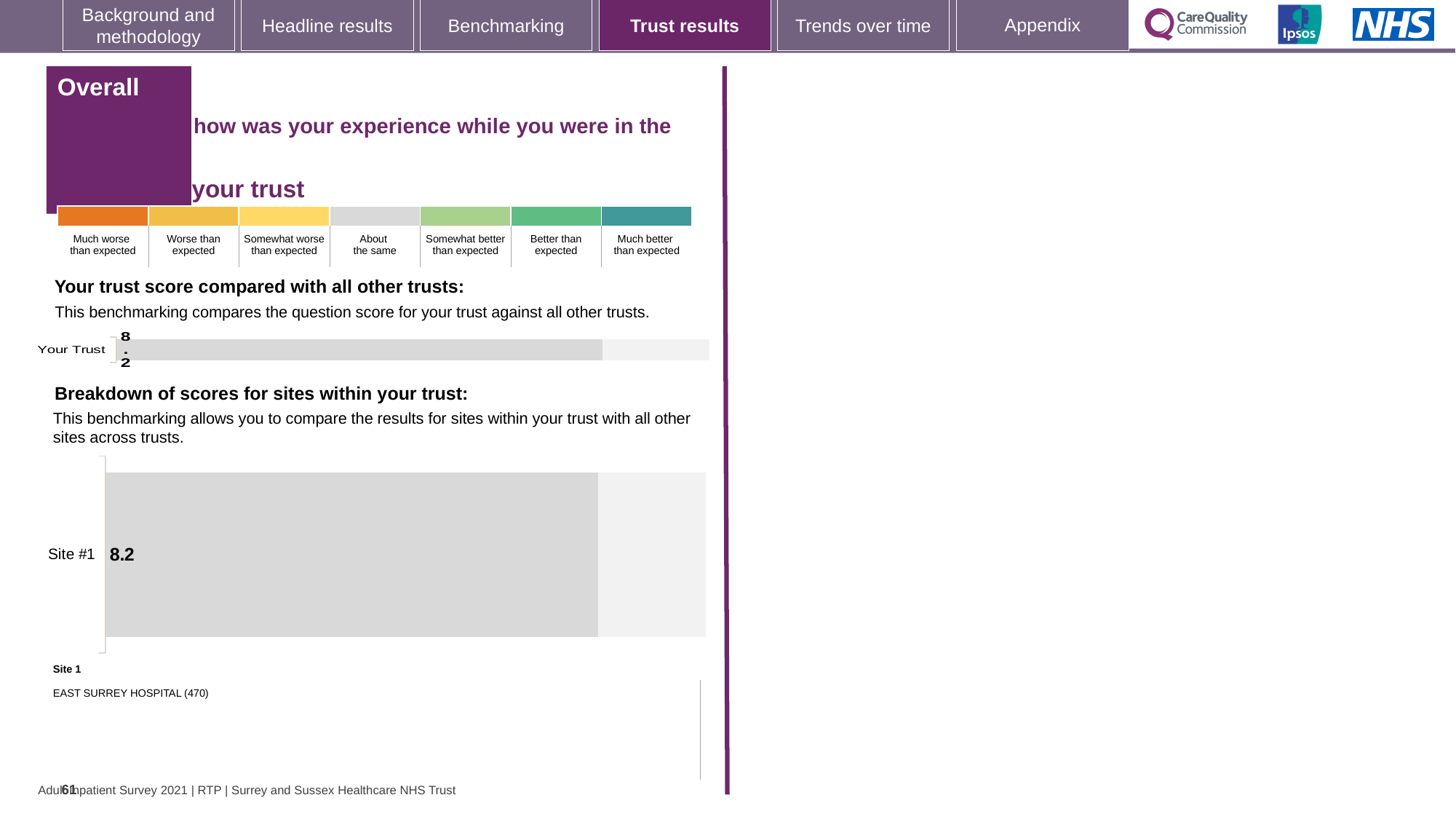
In the 'Your trust score compared with all other trusts' chart, what is the score for Your Trust? 8.2 How many bars are plotted in the 'Your trust score compared with all other trusts' chart? 1 What kind of chart is the 'Breakdown of scores for sites within your trust' chart? bar chart In the 'Breakdown of scores for sites within your trust' chart, what is the score for Site #1? 8.2 What kind of chart is the 'Your trust score compared with all other trusts' chart? bar chart What is the difference between the Site #1 score in the sites chart and the Your Trust score in the trust chart? 0 What is the label of the single bar in the 'Your trust score compared with all other trusts' chart? Your Trust According to the note below the sites chart, which hospital is Site 1? EAST SURREY HOSPITAL (470) How many sites are plotted in the 'Breakdown of scores for sites within your trust' chart? 1